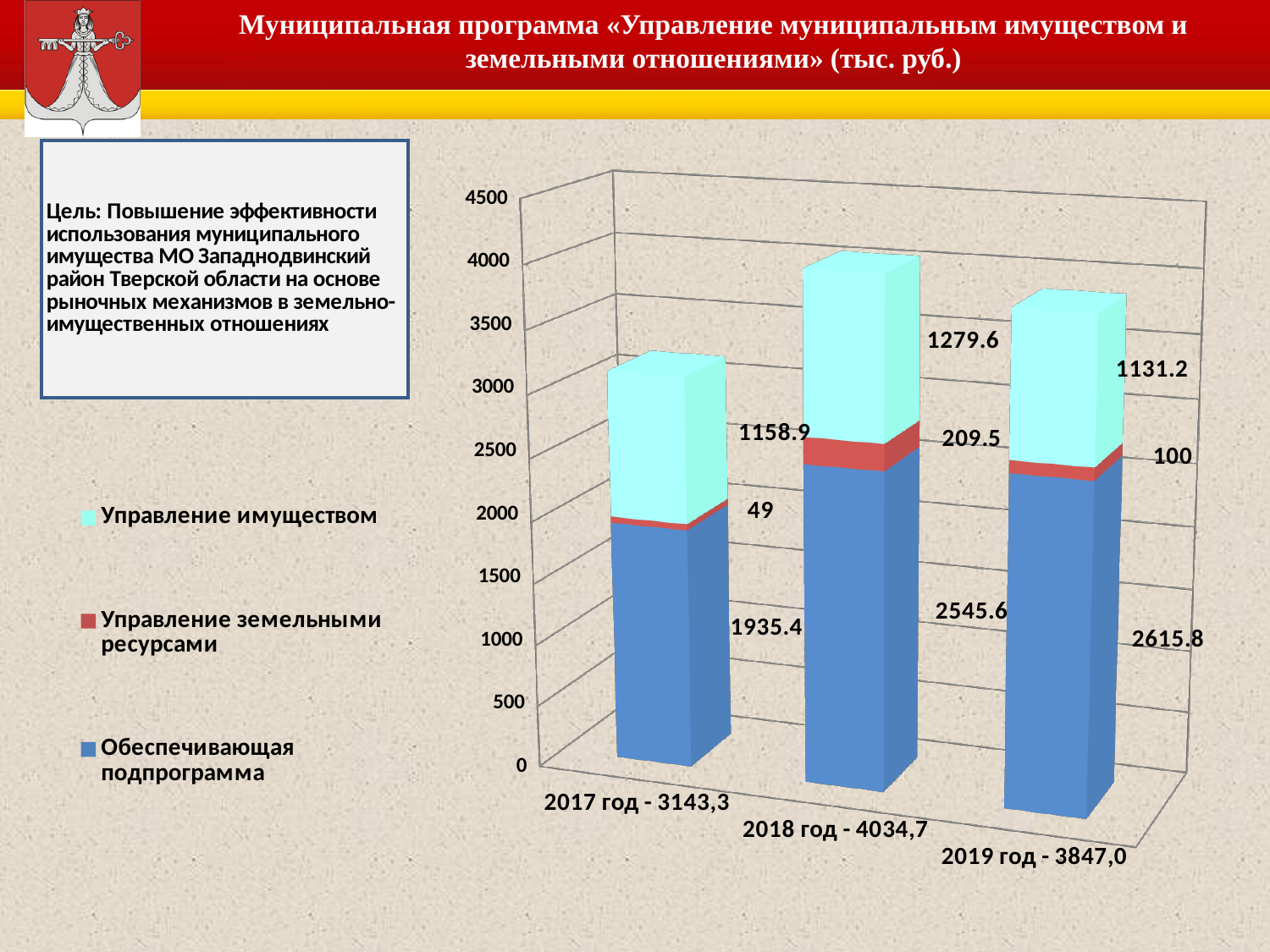
What is the value of «Управление имуществом» for 2019 год? 1131.2 What is the value of «Обеспечивающая подпрограмма» for 2017 год? 1935.4 What is the total of the stacked bar for 2018 год, as printed in its axis label? 4034,7 How many series does the legend list? 3 What is the value of «Управление земельными ресурсами» for 2018 год? 209.5 Which year has the lowest value for «Обеспечивающая подпрограмма»? 2017 год What is the difference between the «Обеспечивающая подпрограмма» values for 2019 год and 2018 год? 70.2 What type of chart is shown on the slide? stacked bar chart Which is larger: «Управление имуществом» for 2017 год or for 2018 год? 2018 год Which year has the highest value for «Управление земельными ресурсами»? 2018 год Which series is shown in blue in the legend? Обеспечивающая подпрограмма How many categories (years) are shown on the x axis? 3